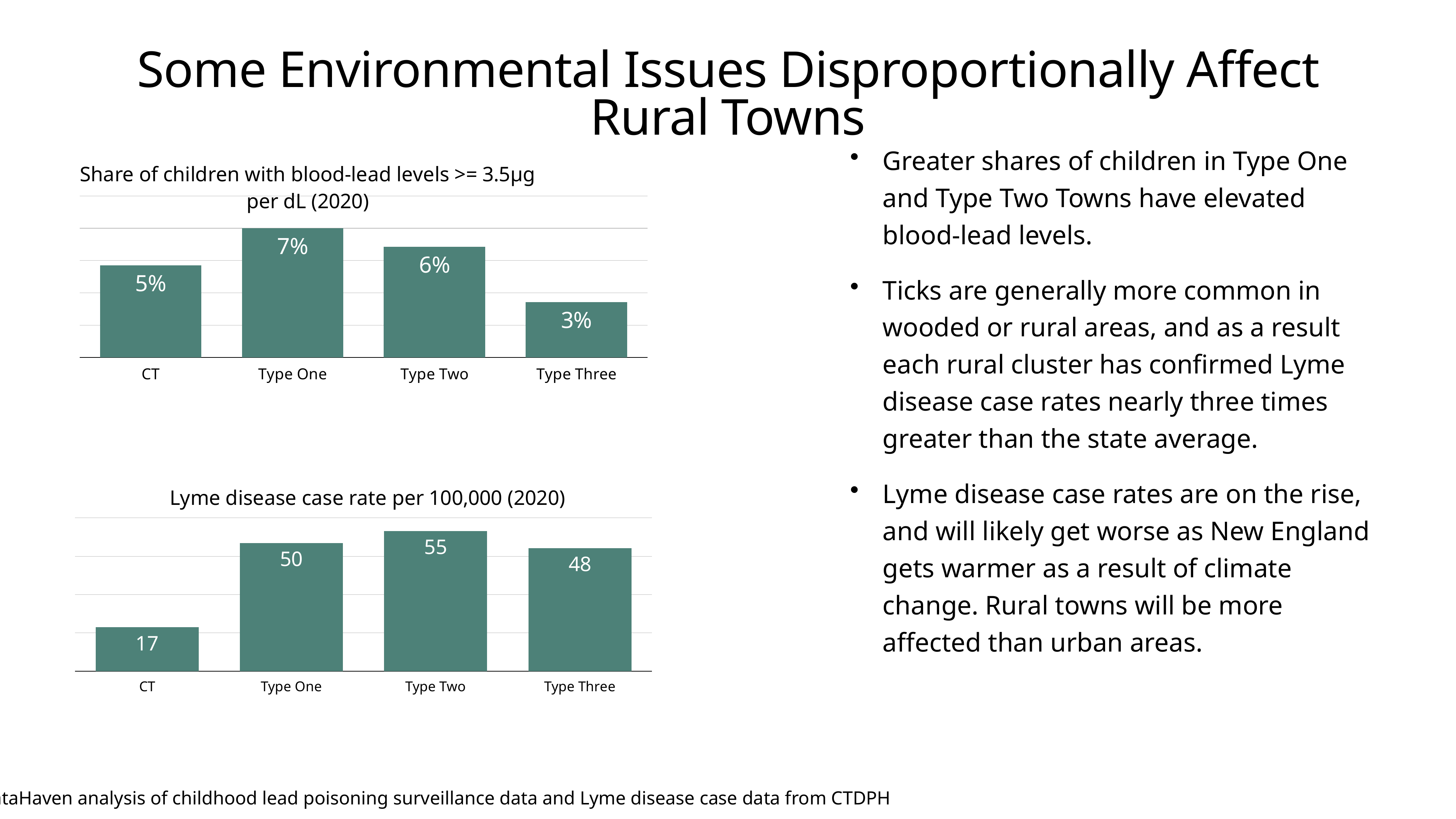
In the Lyme disease case rate chart, which is larger, Type One or Type Three? Type One In the Lyme disease case rate chart, what is the difference between Type One and CT? 33 In the blood-lead levels chart, what is the difference between Type One and Type Three? 4% In the blood-lead levels chart, which category has the highest share? Type One In the Lyme disease case rate chart, which category has the highest case rate? Type Two How many categories are shown in the Lyme disease case rate chart? 4 In the blood-lead levels chart, what is the value for Type Three? 3% In the Lyme disease case rate chart, which category has the lowest case rate? CT In the blood-lead levels chart, what is the value for Type One? 7% In the Lyme disease case rate chart, what is the value for Type Two? 55 In the Lyme disease case rate chart, what is the value for CT? 17 In the blood-lead levels chart, which category has the lowest share? Type Three